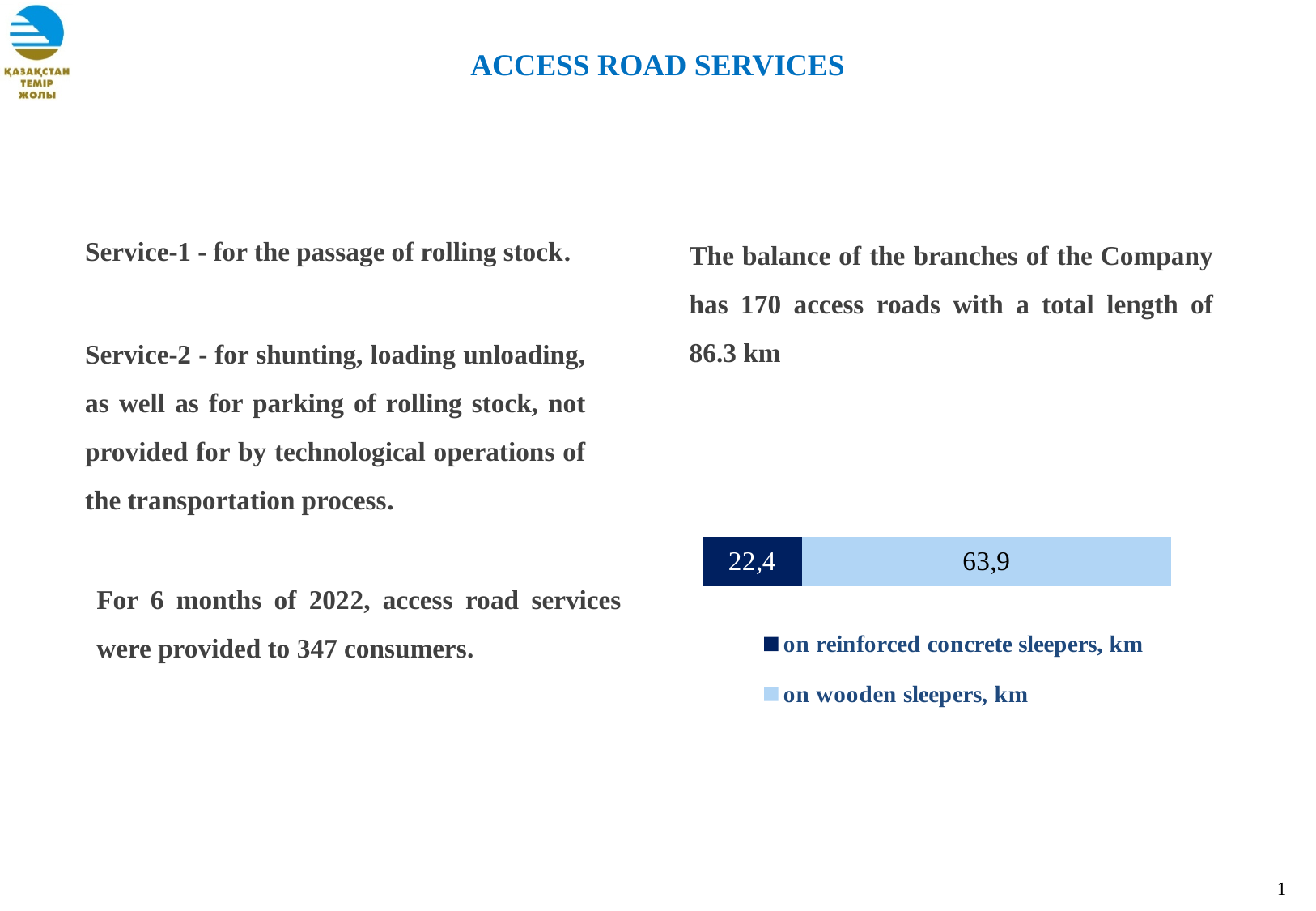
What colour is used for the on reinforced concrete sleepers, km series in the chart? Dark navy blue What is the value for on reinforced concrete sleepers, km in the chart? 22,4 Which series has the larger value in the chart, on reinforced concrete sleepers or on wooden sleepers? on wooden sleepers, km Which series has the largest value in the chart? on wooden sleepers, km How many series does the legend of the chart list? 2 What kind of chart is shown on the slide? Stacked bar chart What is the value for on wooden sleepers, km in the chart? 63,9 What colour is used for the on wooden sleepers, km series in the chart? Light blue What is the difference between the value for on wooden sleepers, km and the value for on reinforced concrete sleepers, km? 41,5 Which series has the smallest value in the chart? on reinforced concrete sleepers, km What is the total of the stacked bar in the chart? 86,3